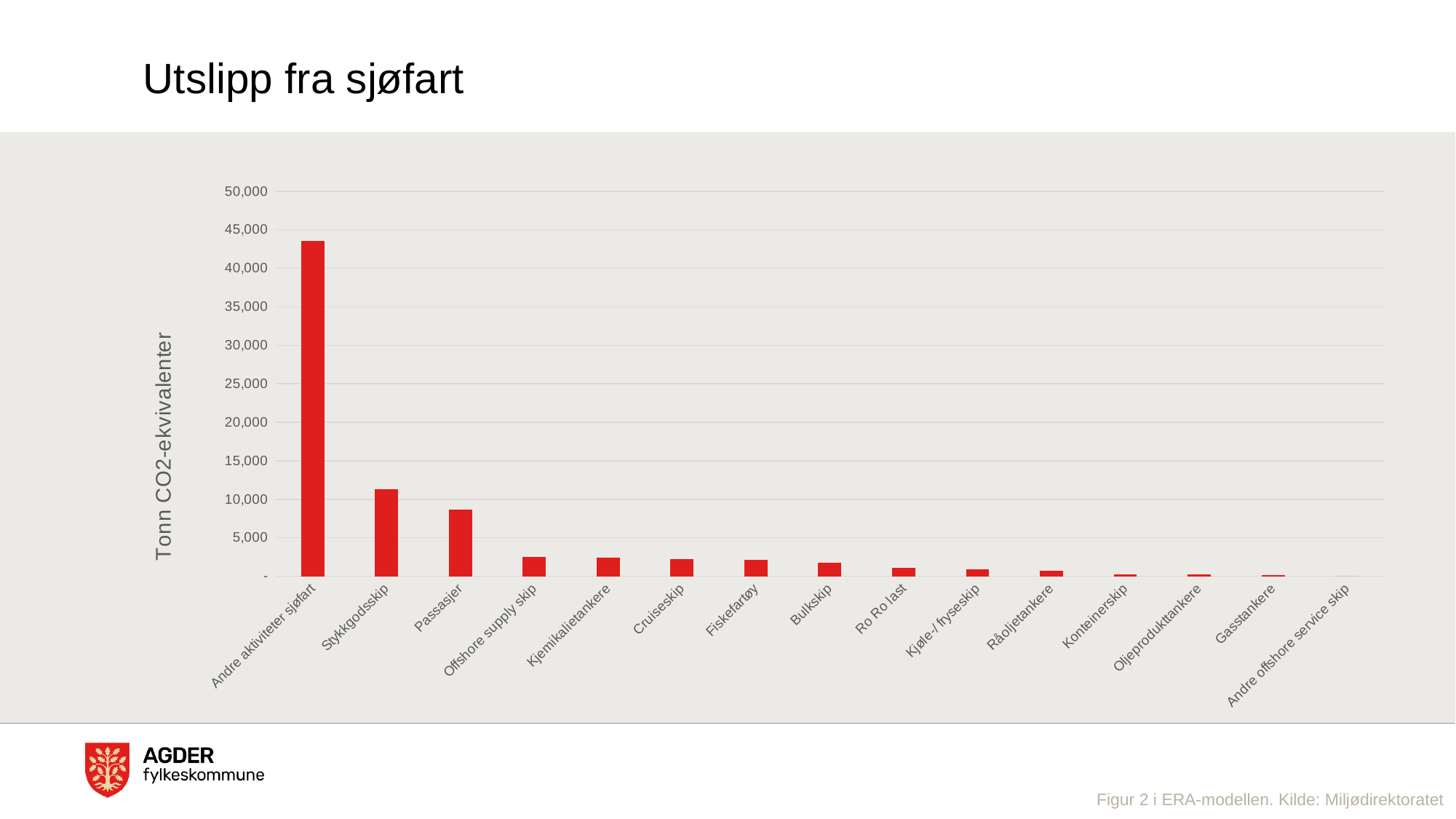
Is the value for Andre aktiviteter sjøfart greater or less than 40,000? greater Which category has the highest emissions in the chart? Andre aktiviteter sjøfart Which is larger, the value for Stykkgodsskip or the value for Passasjer? Stykkgodsskip What kind of chart is shown on the slide? Bar chart What is the label on the y axis of the chart? Tonn CO2-ekvivalenter Is the value for Offshore supply skip greater or less than 5,000? less Is the value for Stykkgodsskip greater or less than 10,000? greater Which category has the lowest emissions in the chart? Andre offshore service skip Do the values rise or fall from left to right along the x axis? Fall What colour are the bars in the chart? Red How many categories are shown on the x axis of the chart? 15